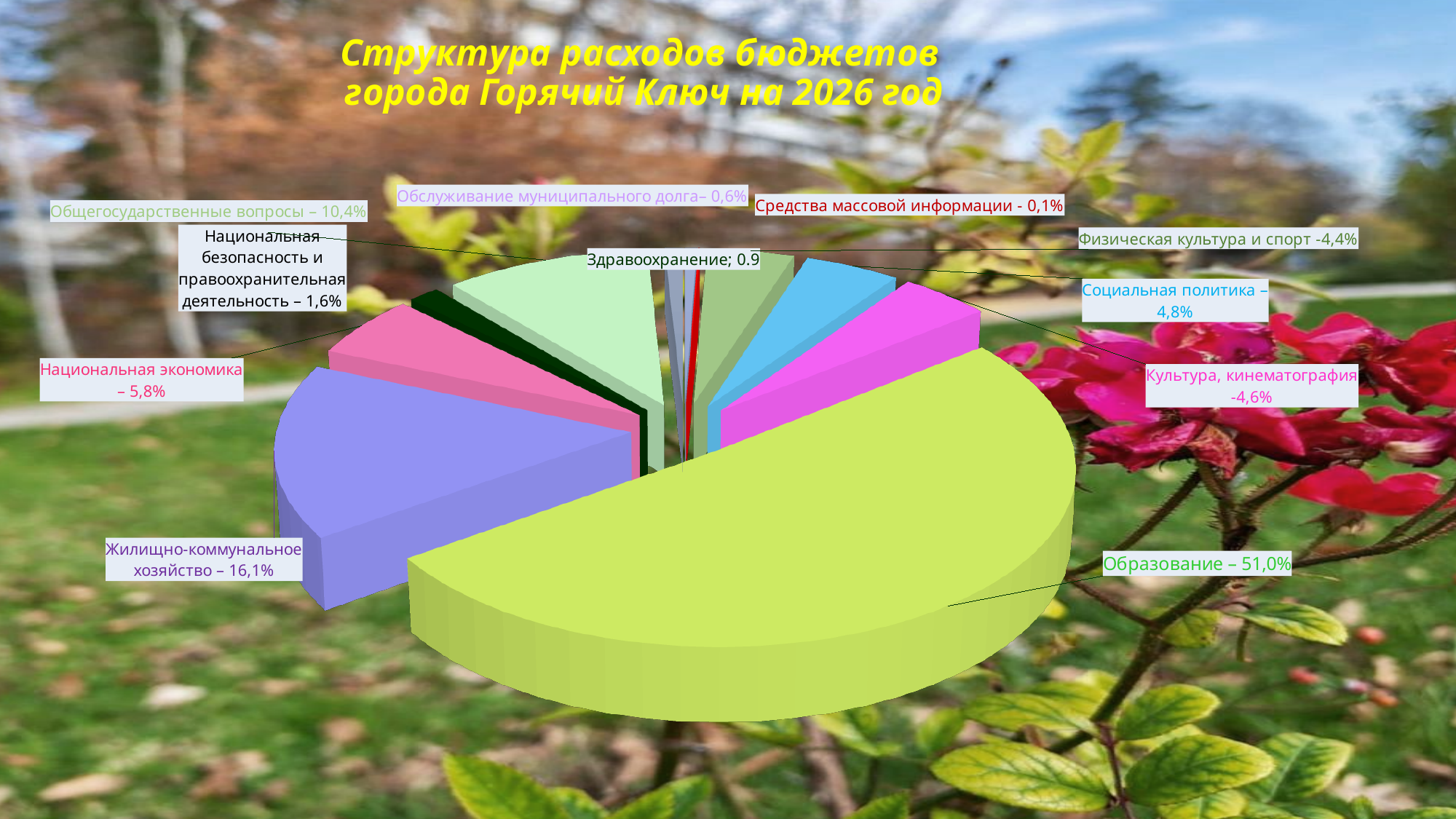
Which category has the smallest share of the pie? Средства массовой информации What is the value shown for Жилищно-коммунальное хозяйство? 16,1% Which has the larger share: Социальная политика or Физическая культура и спорт? Социальная политика What is the difference between the shares of Общегосударственные вопросы and Национальная экономика? 4,6% How many categories are shown in the pie chart? 11 What is the value shown for Национальная безопасность и правоохранительная деятельность? 1,6% What is the title of the chart on the slide? Структура расходов бюджетов города Горячий Ключ на 2026 год What is the value shown for Общегосударственные вопросы? 10,4% What is the difference between the shares of Образование and Жилищно-коммунальное хозяйство? 34,9% What kind of chart is shown on the slide? Pie chart Which category has the largest share of the pie? Образование What share of the budget expenditure goes to Образование? 51,0%